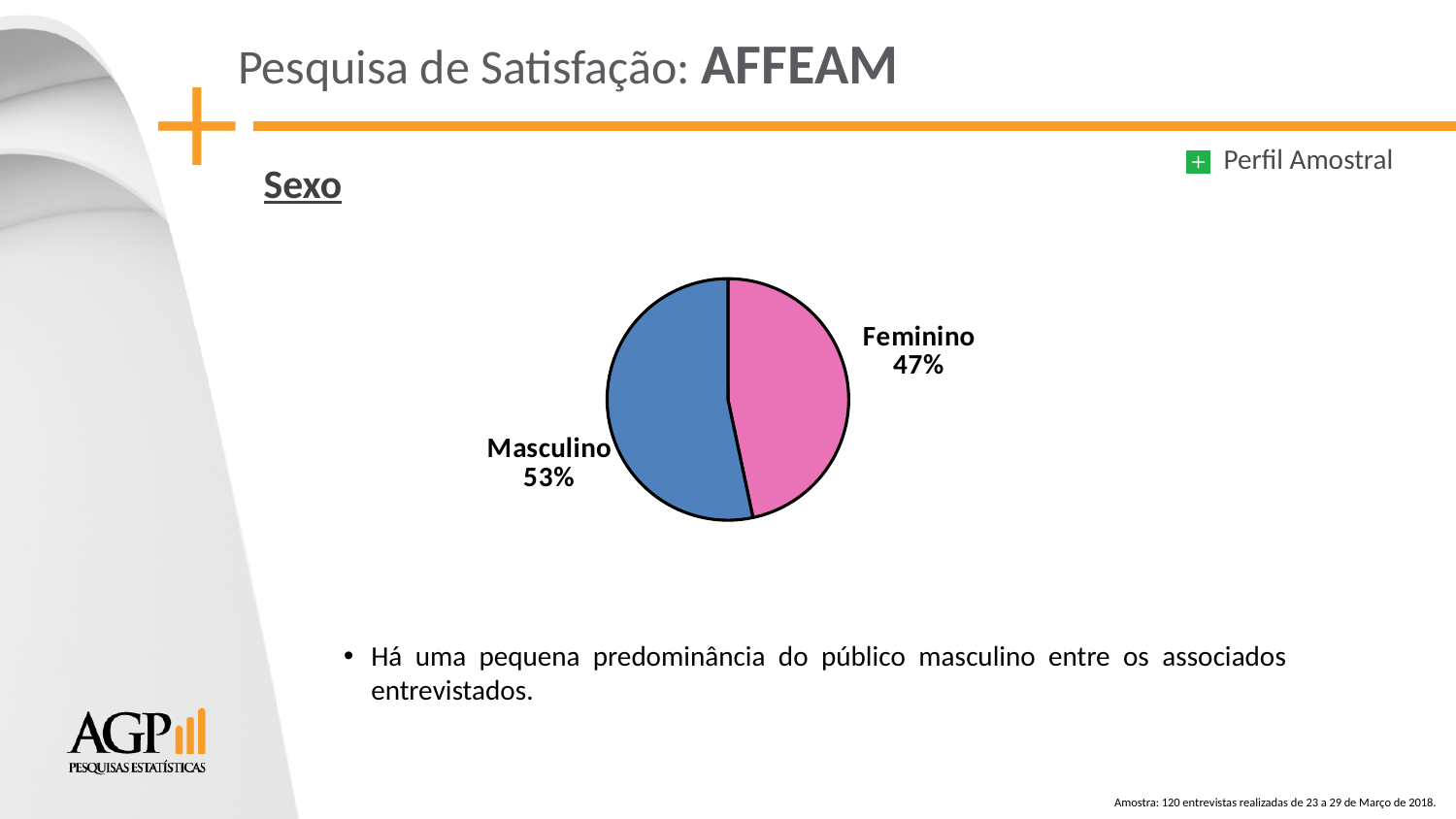
What percentage of respondents are Feminino? 47% What colour is the Masculino slice? Blue How many slices does the pie chart have? 2 What is the difference in percentage points between Masculino and Feminino? 6 Which category has the largest share of the pie? Masculino What is the heading above the pie chart? Sexo What percentage of respondents are Masculino? 53% What type of chart is shown on the slide? Pie chart What share of the pie does the Feminino slice represent? 47% Which is larger, the Masculino share or the Feminino share? Masculino Which category has the smallest share of the pie? Feminino